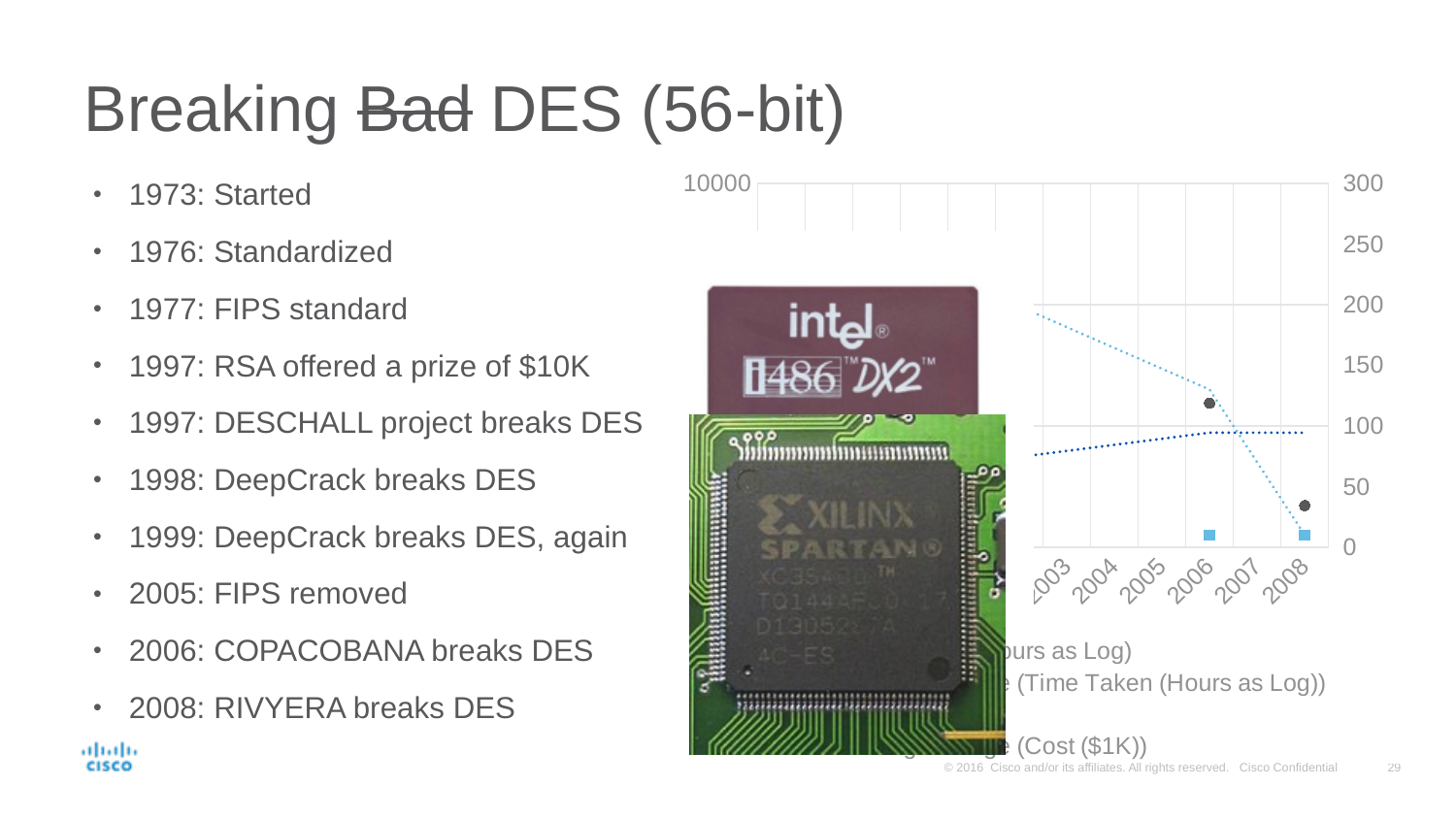
What type of chart is shown on the right of the slide? line chart Is the value of the black dot at 2008 (right axis) greater or less than 50? less Is the value of the blue square at 2006 (right axis) greater or less than 50? less Do the black dots rise or fall from 2006 to 2008? fall Which black dot has the larger value, the one at 2006 or the one at 2008? 2006 What is the highest value shown on the right-hand axis of the chart? 300 What is the value shown at the top of the left-hand axis of the chart? 10000 Is the value of the black dot at 2006 (right axis) greater or less than 100? greater